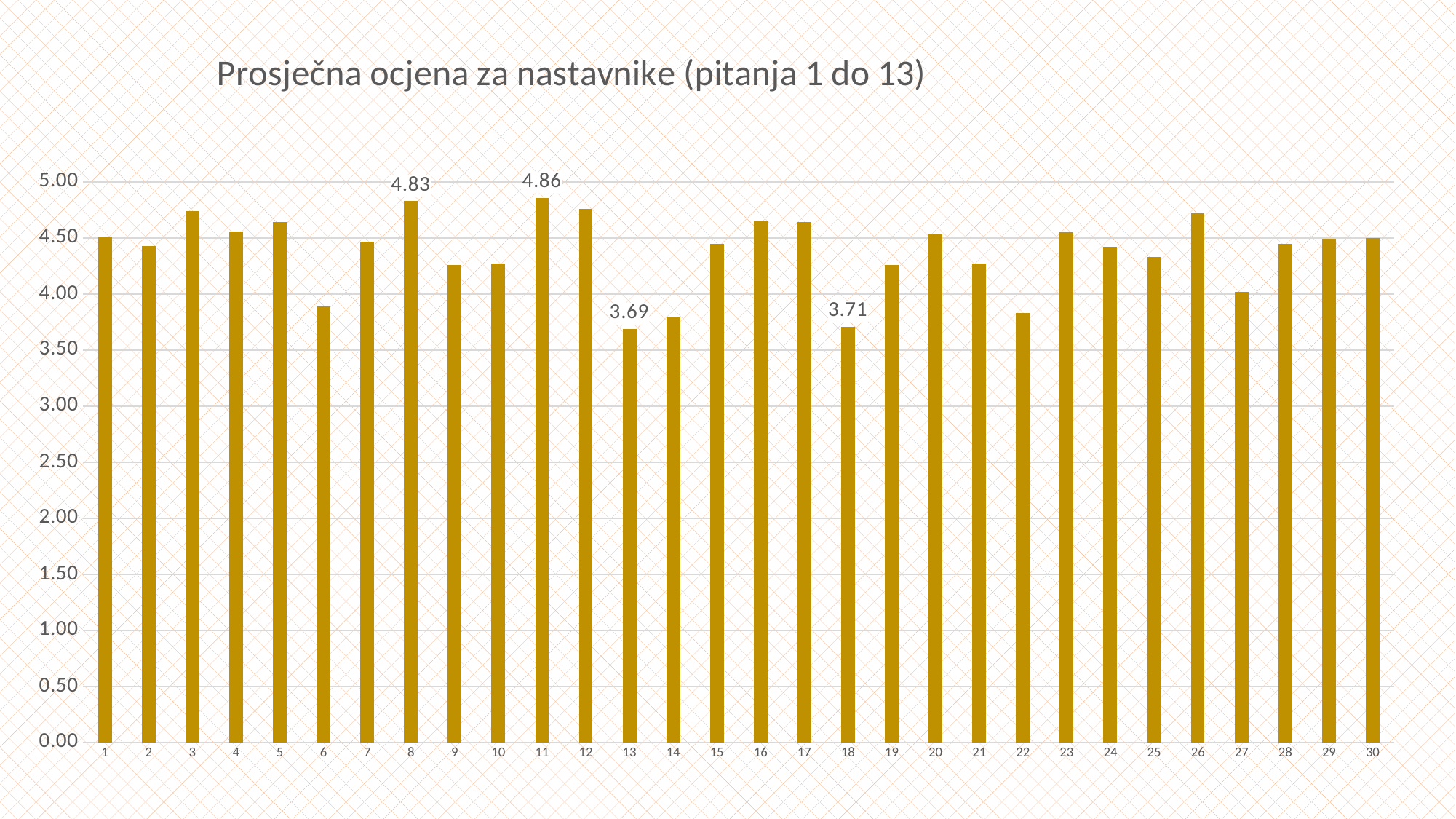
What is the value for category 11? 4.86 What is the difference between the values for categories 11 and 8? 0.03 Which is larger, the value for category 18 or category 13? 18 What is the difference between the values for categories 11 and 13? 1.17 What is the value for category 8? 4.83 How many categories are shown on the x axis? 30 What type of chart is shown on the slide? bar chart Which category has the highest value? 11 Is the value for category 6 greater or less than 4.00? less Which category has the lowest value? 13 What is the value for category 13? 3.69 What is the value for category 18? 3.71